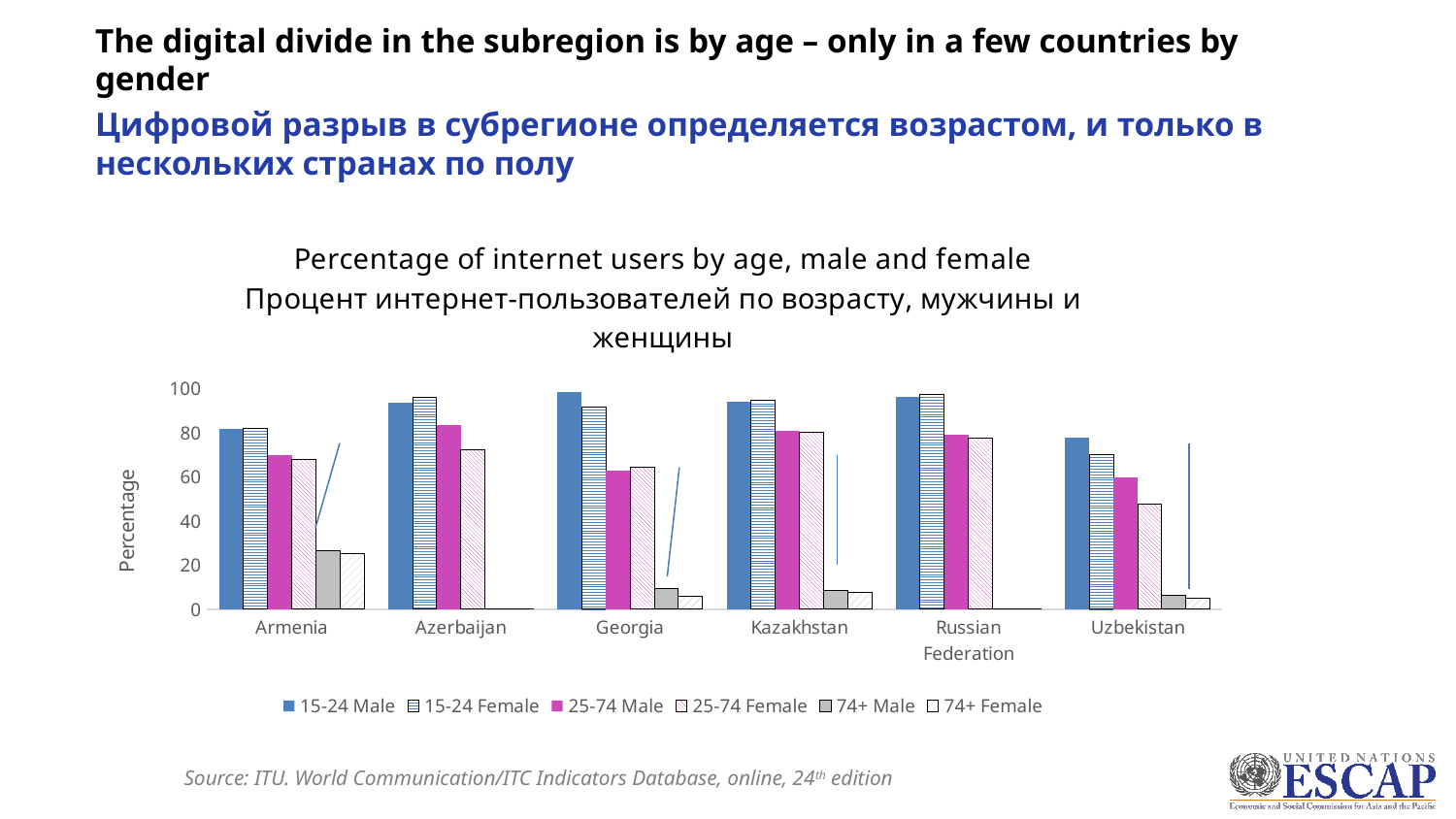
What kind of chart is shown on the slide? bar chart Is the value for 74+ Male in Armenia greater or less than 40? less What is the label on the chart's y axis? Percentage In Uzbekistan, which is larger: the value for 25-74 Male or 25-74 Female? 25-74 Male Which country has the lowest value for 25-74 Female? Uzbekistan Is the value for 15-24 Male in Georgia greater or less than 80? greater Is the value for 25-74 Female in Uzbekistan greater or less than 60? less In Azerbaijan, which is larger: the value for 25-74 Male or 25-74 Female? 25-74 Male How many countries are shown on the x axis of the chart? 6 How many series does the chart's legend list? 6 Which country has the highest value for 74+ Male? Armenia